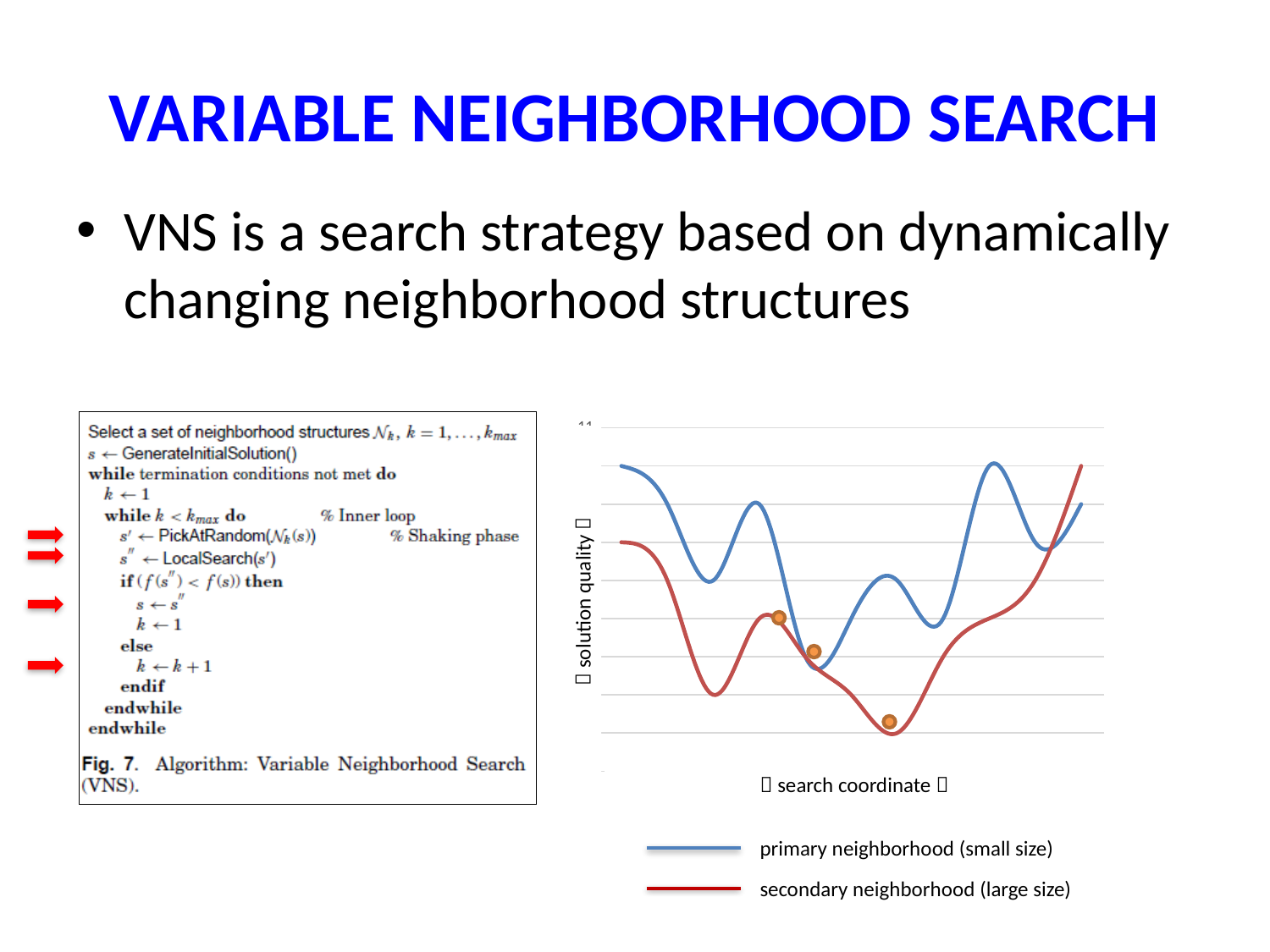
What does the blue line in the chart represent according to the legend? primary neighborhood (small size) What kind of chart is shown on the right of the slide? line chart How many series does the legend of the chart list? 2 Which series reaches the lowest point on the chart, the primary neighborhood or the secondary neighborhood? secondary neighborhood (large size) What is the label of the vertical axis of the chart? solution quality How many orange marker points are drawn on the chart? 3